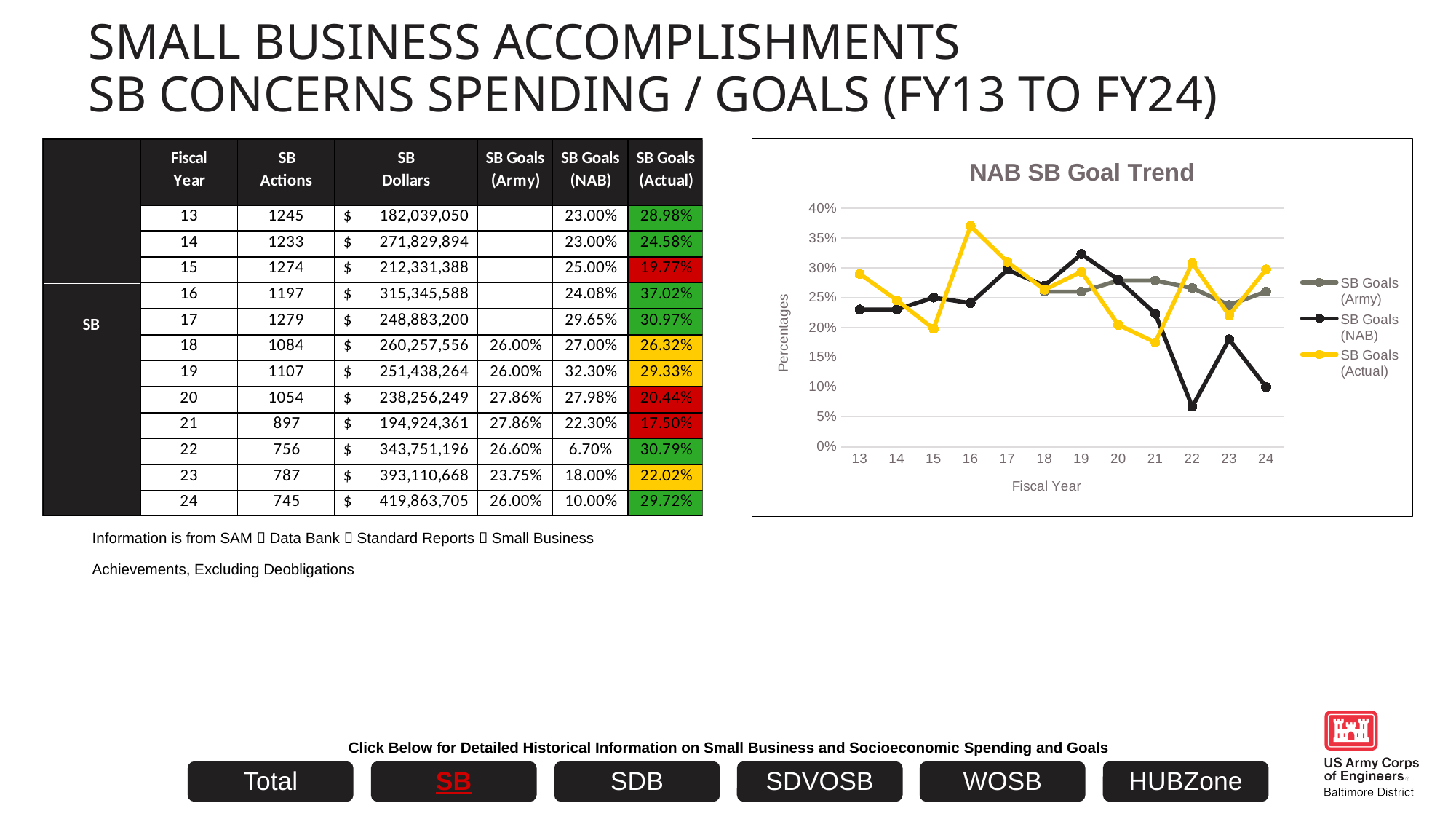
What is the title of the chart on the right of the slide? NAB SB Goal Trend In the NAB SB Goal Trend chart, is the SB Goals (NAB) value for fiscal year 22 greater or less than 10%? less In the NAB SB Goal Trend chart, does the SB Goals (NAB) line rise or fall from fiscal year 19 to fiscal year 22? fall In the NAB SB Goal Trend chart, in which fiscal year does the SB Goals (NAB) line reach its lowest point? 22 What kind of chart is the NAB SB Goal Trend chart? line chart In the NAB SB Goal Trend chart, is the SB Goals (NAB) value for fiscal year 24 greater or less than 15%? less In the NAB SB Goal Trend chart, what colour is the SB Goals (Actual) line? yellow In the NAB SB Goal Trend chart, is the SB Goals (Actual) value for fiscal year 16 greater or less than 35%? greater In the NAB SB Goal Trend chart, which is higher in fiscal year 22: SB Goals (Actual) or SB Goals (NAB)? SB Goals (Actual) How many series does the legend of the NAB SB Goal Trend chart list? 3 In the NAB SB Goal Trend chart, in which fiscal year does the SB Goals (Actual) line reach its highest point? 16 How many fiscal years are plotted along the x axis of the NAB SB Goal Trend chart? 12